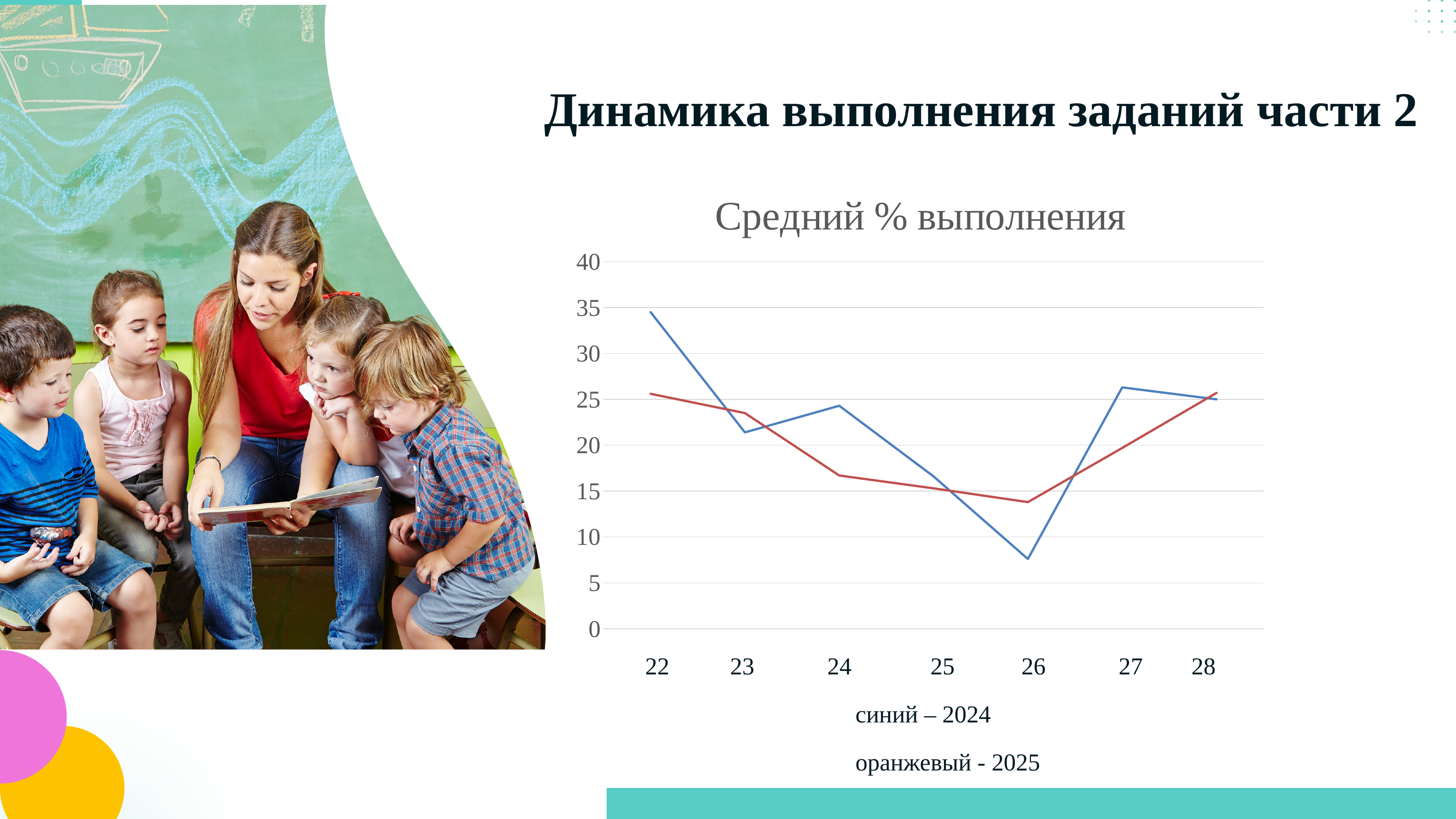
Is the value of the blue (2024) line for task 22 greater or less than 30? greater How many series (years) does the chart show? 2 For the blue (2024) line, at which task number is the value highest? 22 For task 22, which line has the larger value, blue (2024) or orange (2025)? blue (2024) Is the value of the blue (2024) line for task 26 greater or less than 10? less Is the value of the orange (2025) line for task 24 greater or less than 20? less For task 26, which line has the larger value, blue (2024) or orange (2025)? orange (2025) For the orange (2025) line, at which task number is the value lowest? 26 How many task numbers are plotted along the x axis of the chart? 7 What is the title of the chart? Средний % выполнения What kind of chart is shown on the slide? line chart For the blue (2024) line, at which task number is the value lowest? 26